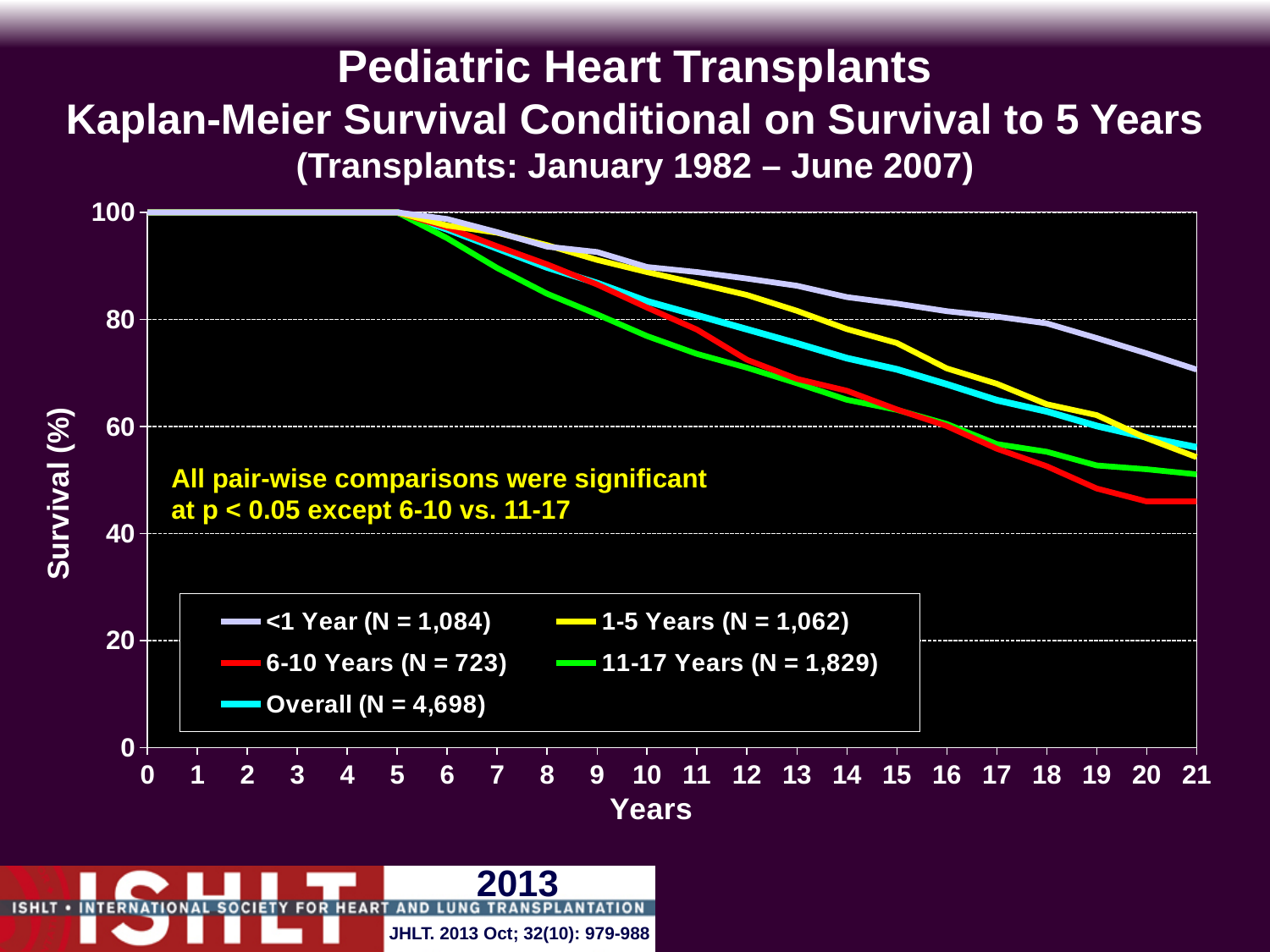
How many series does the legend list? 5 What is the label of the y axis? Survival (%) Which series has the highest survival at 21 years? <1 Year What is the N for the 11-17 Years group shown in the legend? 1,829 At 21 years, is survival higher for the <1 Year group or the 6-10 Years group? <1 Year Is the survival value for the 6-10 Years group at 21 years greater or less than 60? less What kind of chart is shown on the slide? Line chart Is the survival value for the 11-17 Years group at 10 years greater or less than 80? less Which series has the lowest survival at 21 years? 6-10 Years What is the N for the Overall group shown in the legend? 4,698 Do the survival curves rise or fall as years increase beyond 5? Fall Is the survival value for the <1 Year group at 21 years greater or less than 60? greater